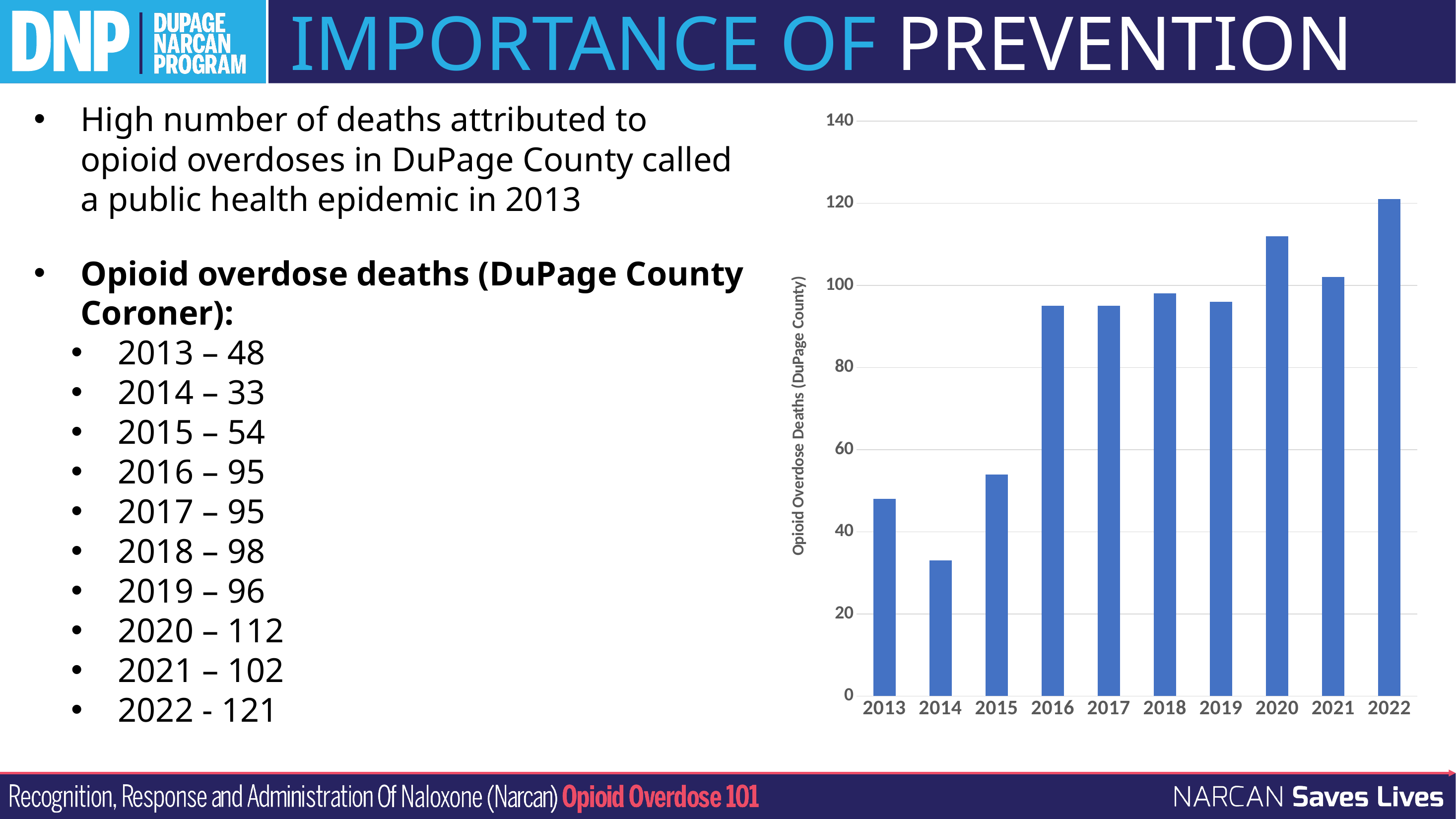
What is the label on the vertical axis of the chart? Opioid Overdose Deaths (DuPage County) What kind of chart is shown on the slide? bar chart Which year has the highest number of opioid overdose deaths in the chart? 2022 Is the value for 2014 greater or less than 40? less Is the value for 2018 greater or less than 80? greater Which year has more opioid overdose deaths, 2020 or 2021? 2020 How many years are plotted on the x axis of the chart? 10 What is the number of opioid overdose deaths for 2014? 33 What is the difference in opioid overdose deaths between 2022 and 2013? 73 What is the number of opioid overdose deaths for 2020? 112 What is the number of opioid overdose deaths for 2022? 121 Which year has the lowest number of opioid overdose deaths in the chart? 2014